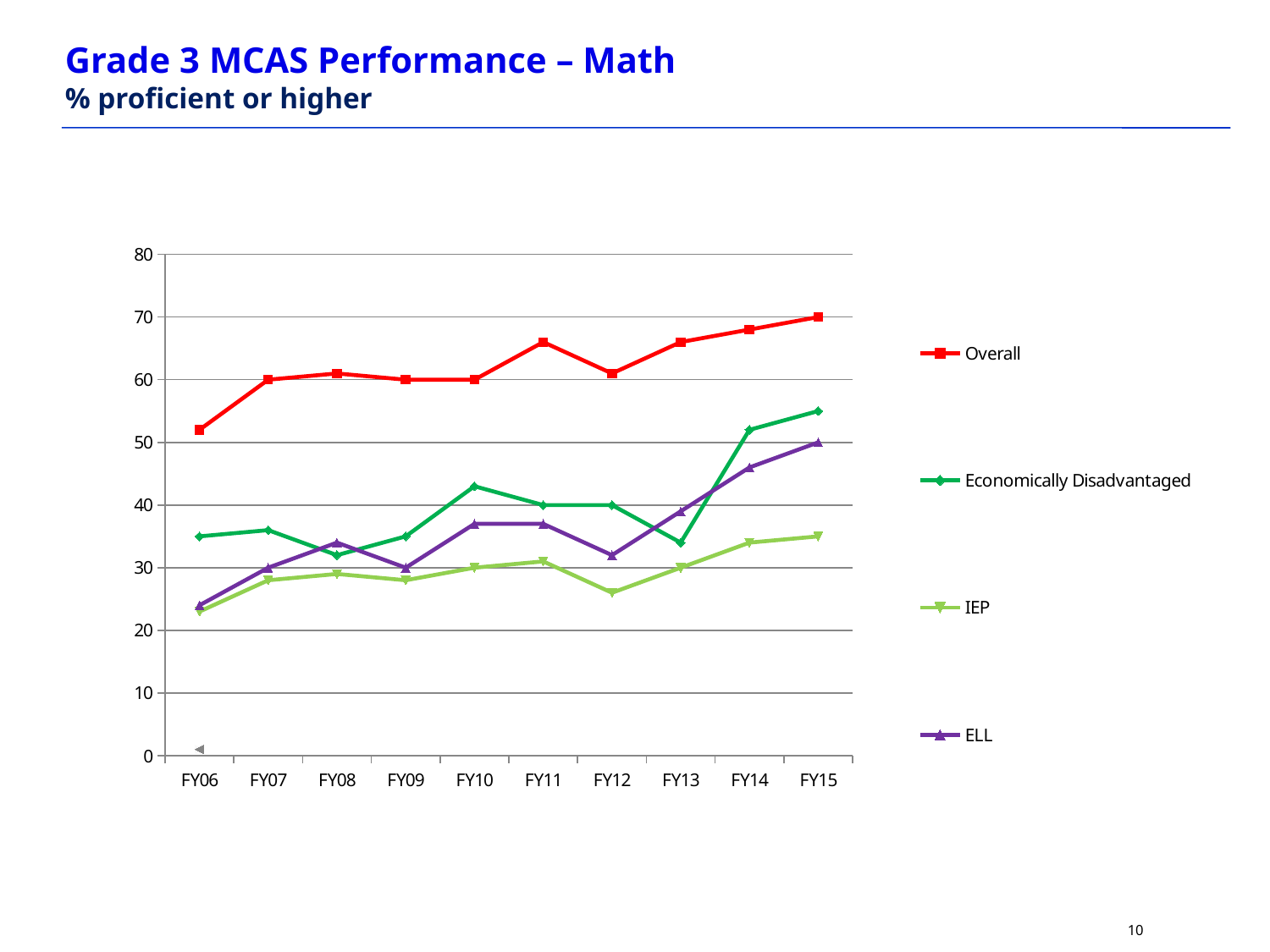
Is the ELL value for FY14 greater or less than 40? greater How many fiscal years are shown on the x axis? 10 Is the Economically Disadvantaged value for FY14 greater or less than 50? greater In FY13, which is larger: the ELL value or the Economically Disadvantaged value? ELL How many series does the legend list? 4 Is the IEP value for FY12 greater or less than 30? less Does the Overall series generally rise or fall from FY06 to FY15? rise Which series has the highest value in FY15? Overall What is the subtitle of the chart below the main title? % proficient or higher Which series has the lowest value in FY12? IEP What kind of chart is shown on the slide? line chart